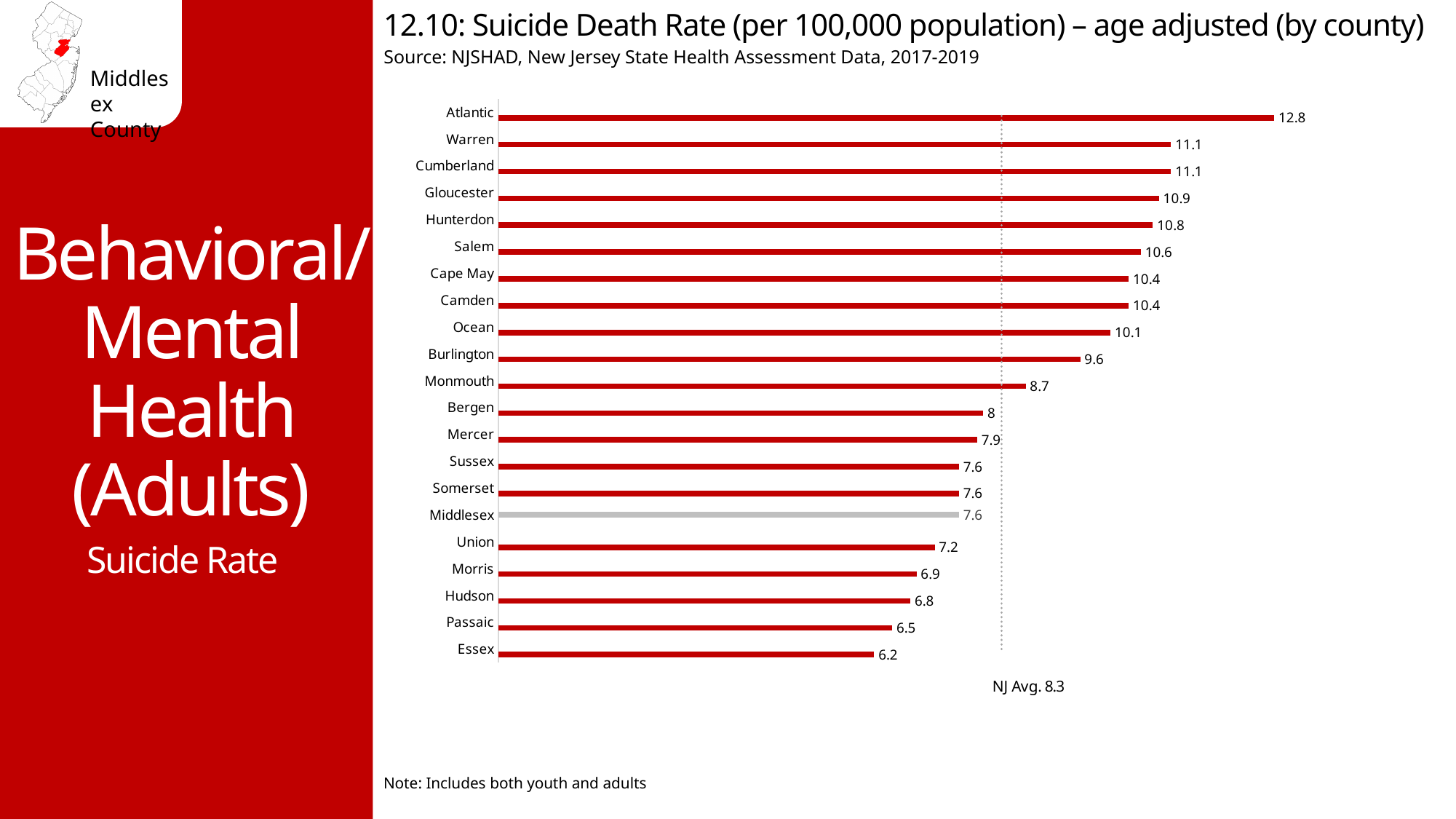
What is the suicide death rate for Middlesex County? 7.6 What is the difference between the suicide death rates of Atlantic and Essex counties? 6.6 What is the NJ average suicide death rate shown on the chart? 8.3 What is the suicide death rate for Monmouth County? 8.7 Which county has the lowest suicide death rate? Essex What kind of chart is shown on the slide? Bar chart How many counties are shown in the chart? 21 What is the suicide death rate for Atlantic County? 12.8 Which county has a higher suicide death rate, Bergen or Hudson? Bergen Which county has the highest suicide death rate? Atlantic What is the difference between the suicide death rates of Middlesex and Union counties? 0.4 Which county's bar is shown in grey rather than red? Middlesex